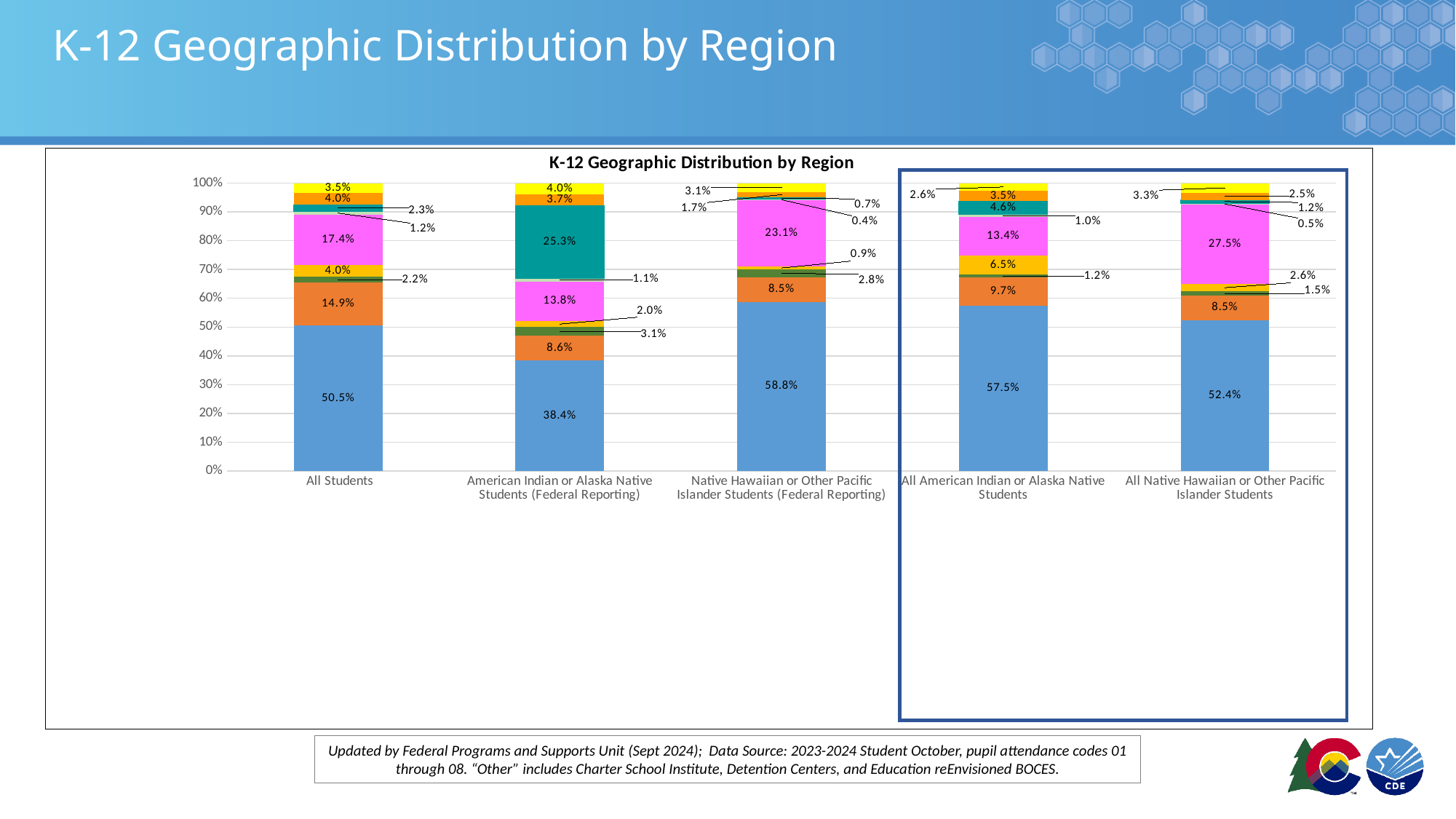
How many student categories are shown along the x axis? 5 What is the value of the bottom (blue) segment for American Indian or Alaska Native Students (Federal Reporting)? 38.4% What is the value of the orange segment directly above the blue segment in the All Students bar? 14.9% Which category has the largest bottom (blue) segment? Native Hawaiian or Other Pacific Islander Students (Federal Reporting) What type of chart is shown on the slide? Stacked bar chart What is the difference between the bottom (blue) segment values for Native Hawaiian or Other Pacific Islander Students (Federal Reporting) and American Indian or Alaska Native Students (Federal Reporting)? 20.4 percentage points What is the value of the bottom (blue) segment of the All Students bar? 50.5% What is the title of the chart? K-12 Geographic Distribution by Region Which has a larger magenta segment: All Students or All American Indian or Alaska Native Students? All Students What is the value of the magenta segment for All Native Hawaiian or Other Pacific Islander Students? 27.5% Which two categories are enclosed in the dark blue box on the chart? All American Indian or Alaska Native Students and All Native Hawaiian or Other Pacific Islander Students Which category has the smallest bottom (blue) segment? American Indian or Alaska Native Students (Federal Reporting)